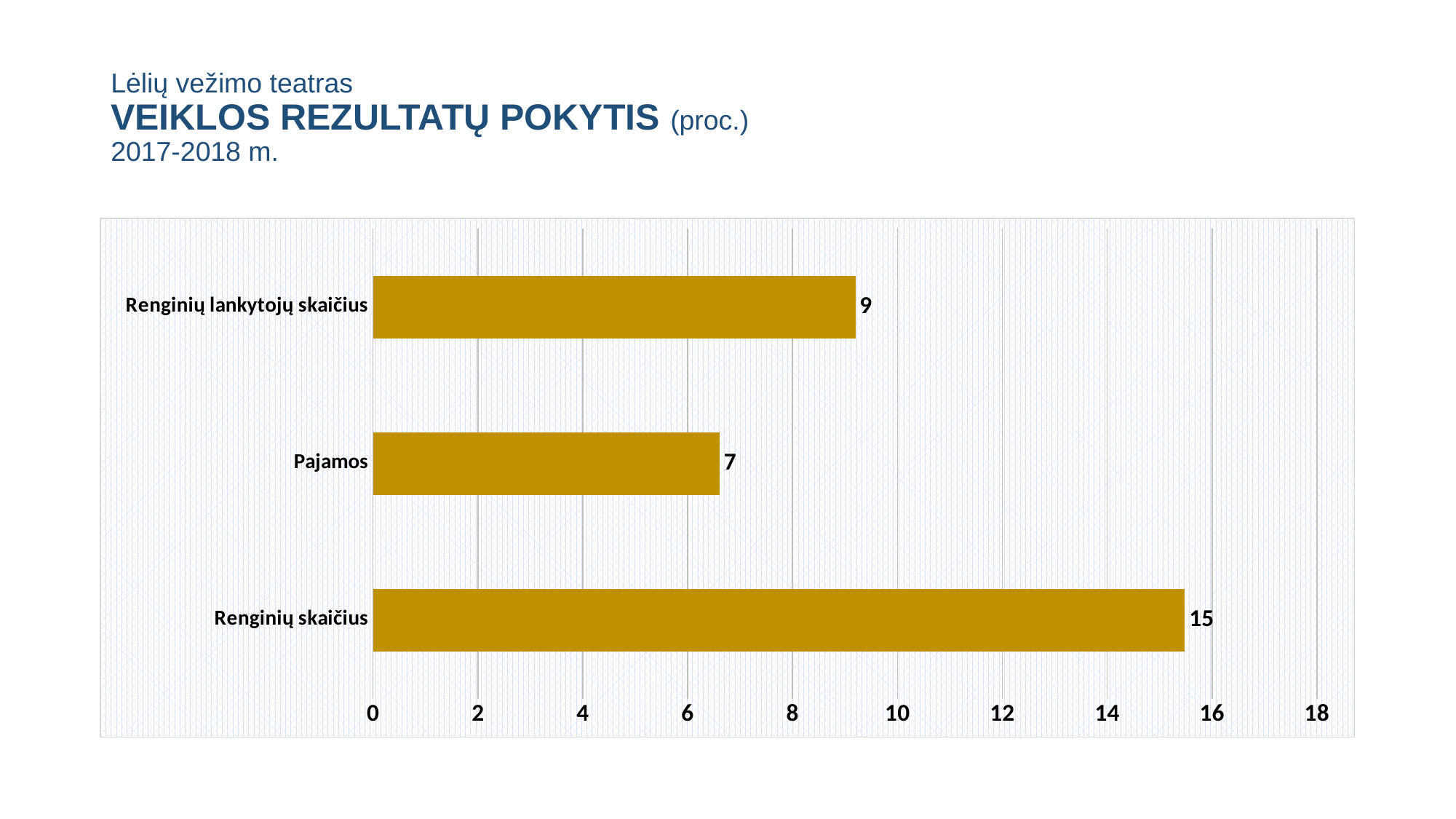
What is the difference between the values for Renginių lankytojų skaičius and Pajamos? 2 Which is larger, the value for Renginių lankytojų skaičius or the value for Pajamos? Renginių lankytojų skaičius What is the value for Renginių skaičius? 15 Is the value for Renginių skaičius greater or less than 14? greater Which category has the highest value? Renginių skaičius How many categories are shown in the chart? 3 What is the value for Renginių lankytojų skaičius? 9 What is the value for Pajamos? 7 What kind of chart is shown on the slide? bar chart What is the main title of the slide? VEIKLOS REZULTATŲ POKYTIS (proc.) What is the difference between the values for Renginių skaičius and Pajamos? 8 Which category has the lowest value? Pajamos